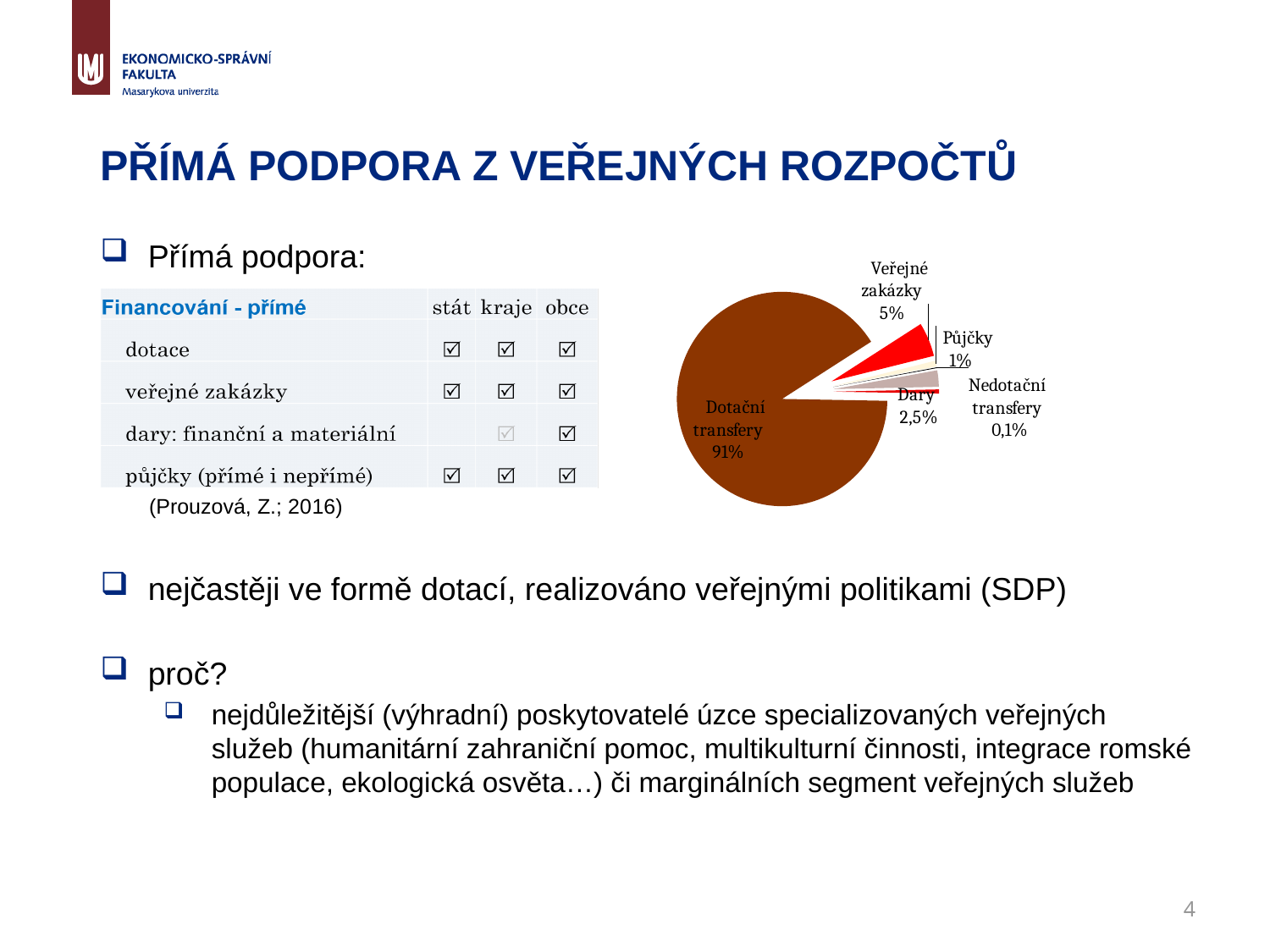
What share of the pie does Dotační transfery have? 91% What colour is the Dotační transfery slice of the pie chart? brown What is the difference in percentage points between Veřejné zakázky and Půjčky? 4 How many slices does the pie chart have? 6 What share of the pie does Půjčky have? 1% What kind of chart is shown on the slide? pie chart Which slice of the pie chart is the largest? Dotační transfery What share of the pie does Dary have? 2,5% What share of the pie does Nedotační transfery have? 0,1% What share of the pie does Veřejné zakázky have? 5% Which slice of the pie chart is the smallest? Nedotační transfery Which is larger in the pie chart, Veřejné zakázky or Dary? Veřejné zakázky